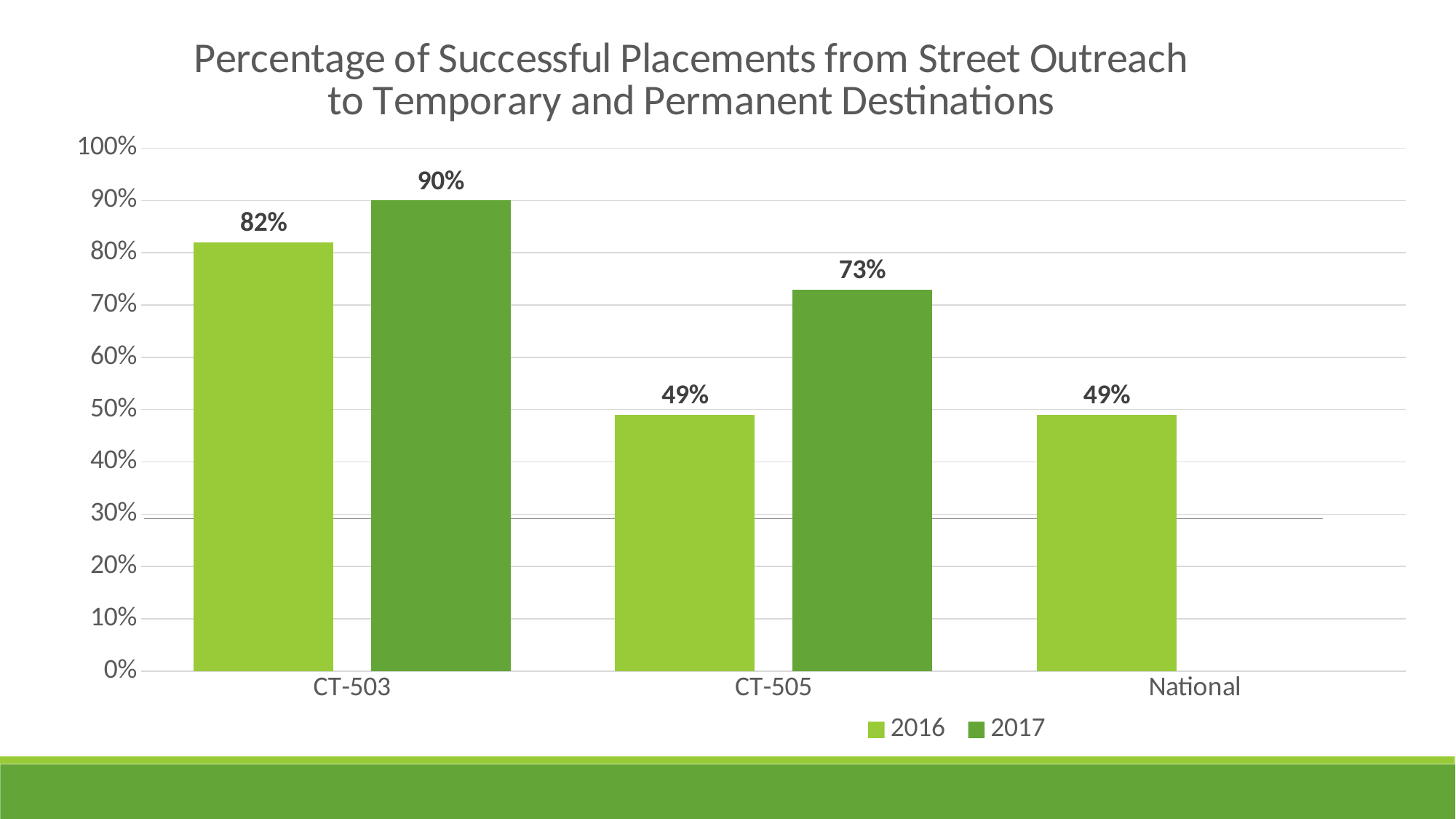
What kind of chart is shown on the slide? Bar chart Which category has the lowest 2017 value? CT-505 Which series is shown in the darker green colour? 2017 How many series does the legend list? 2 What is the 2016 value for National? 49% What is the difference between the 2017 values for CT-503 and CT-505? 17% What is the 2016 value for CT-503? 82% Which category has the highest 2017 value? CT-503 Which is larger, the 2016 value for CT-503 or the 2016 value for CT-505? CT-503 What is the difference between the 2017 and 2016 values for CT-505? 24% How many categories are shown on the x axis? 3 What is the 2017 value for CT-505? 73%